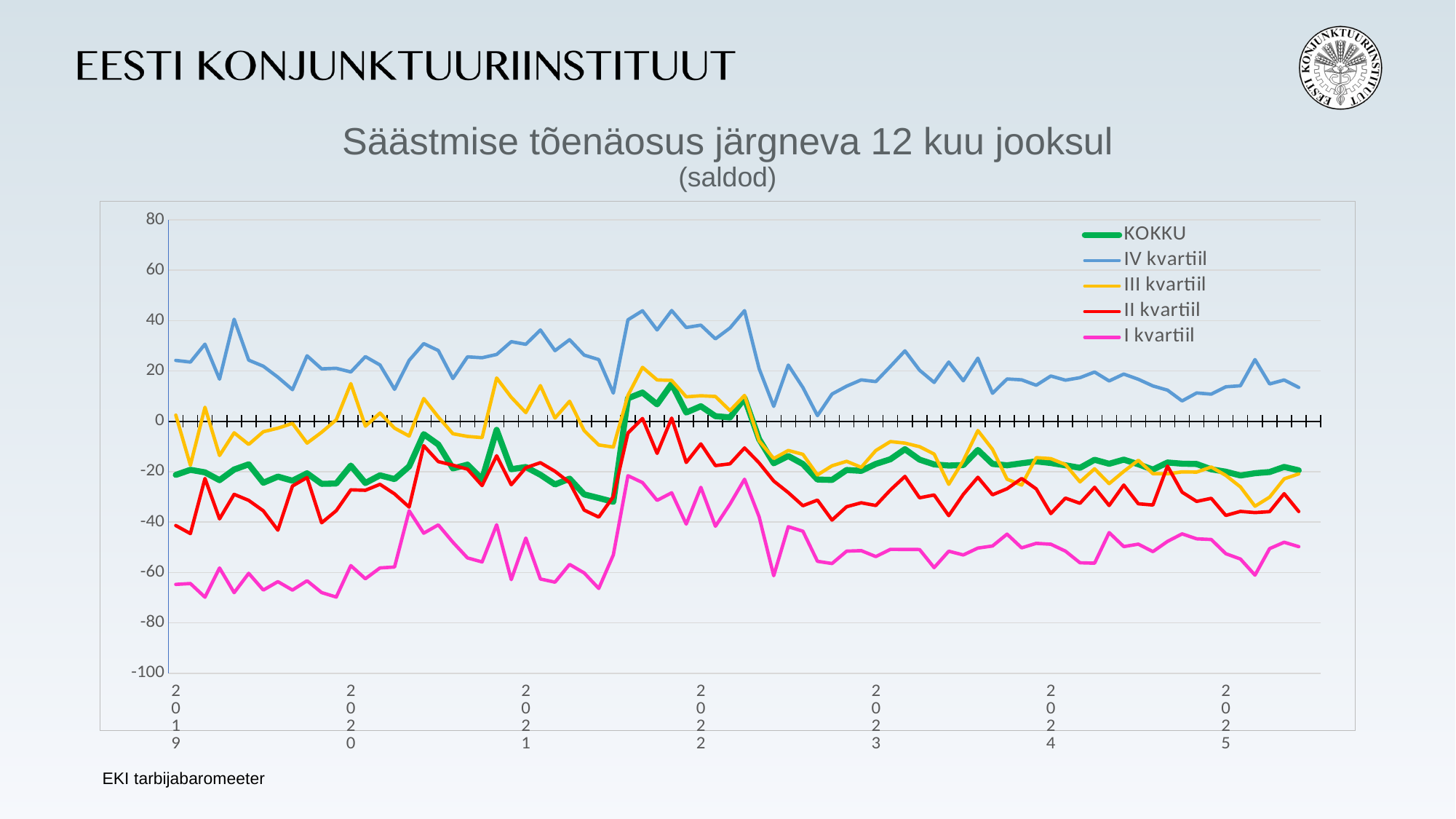
How many series does the legend list? 5 Does the I kvartiil line overall rise or fall from 2019 to 2025? rise What kind of chart is shown on the slide? line chart What is the title of the chart? Säästmise tõenäosus järgneva 12 kuu jooksul (saldod) Is the value for KOKKU at the start of 2019 greater or less than 0? less Is the value for I kvartiil at the start of 2019 greater or less than -60? less Which series is drawn with the thick green line? KOKKU How many years are labelled on the x axis? 7 Is the value for IV kvartiil at the start of 2019 greater or less than 0? greater At the start of 2019, which is higher, II kvartiil or I kvartiil? II kvartiil Which series has the highest values across the whole period? IV kvartiil Which series has the lowest values across the whole period? I kvartiil